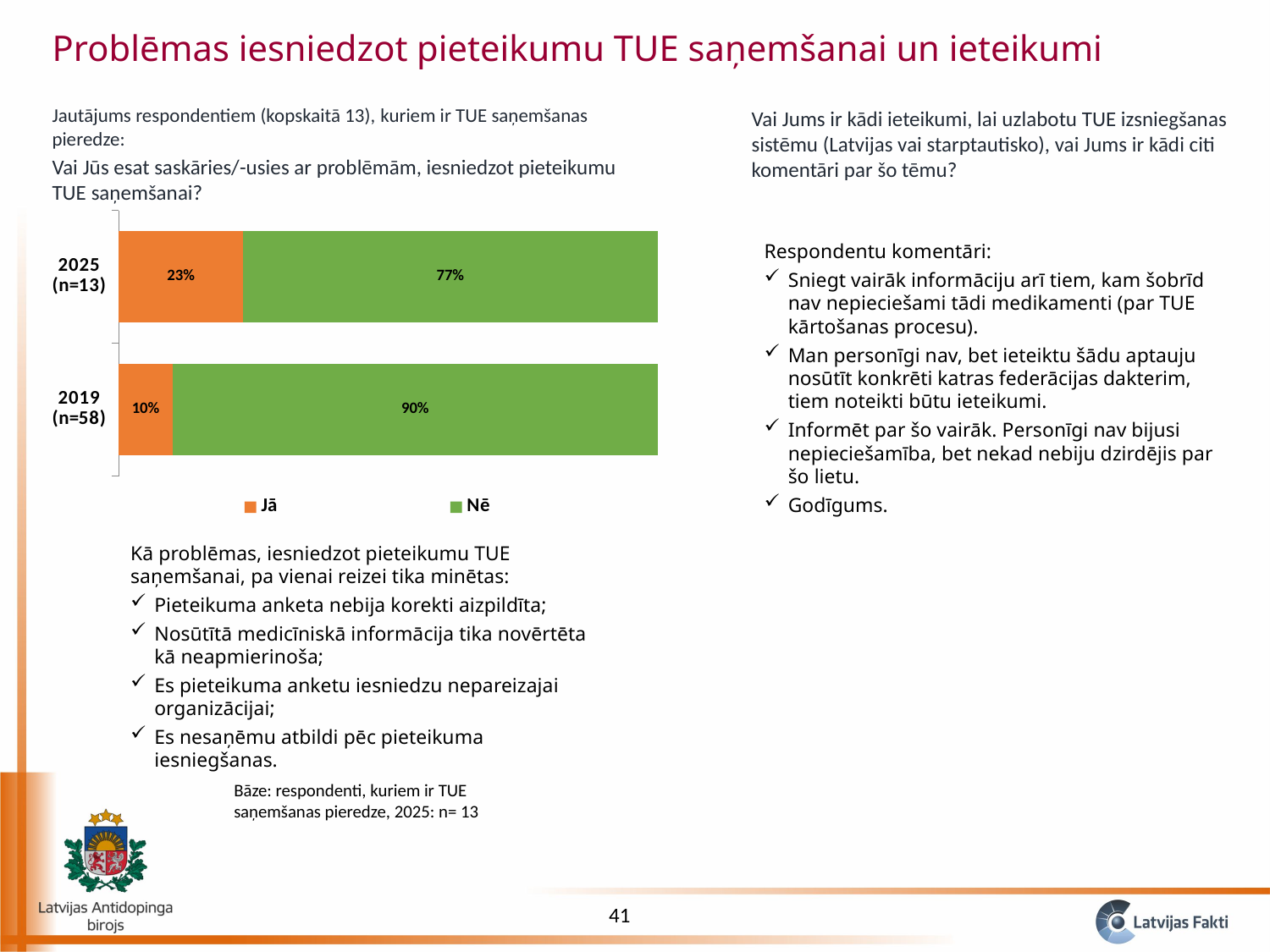
What is the difference between the "Jā" share in 2025 and in 2019? 13% What percentage of respondents answered "Jā" in 2019 (n=58)? 10% What percentage of respondents answered "Nē" in 2019 (n=58)? 90% Which colour represents the "Nē" series in the chart? Green What percentage of respondents answered "Jā" in 2025 (n=13)? 23% What is the difference between the "Nē" share in 2019 and in 2025? 13% What percentage of respondents answered "Nē" in 2025 (n=13)? 77% How many series does the legend list? 2 What kind of chart is shown on the slide? Stacked bar chart What is the total of the stacked bar for 2025 (n=13)? 100% How many categories (years) are shown in the chart? 2 Which year has the higher share of "Jā" answers, 2025 or 2019? 2025